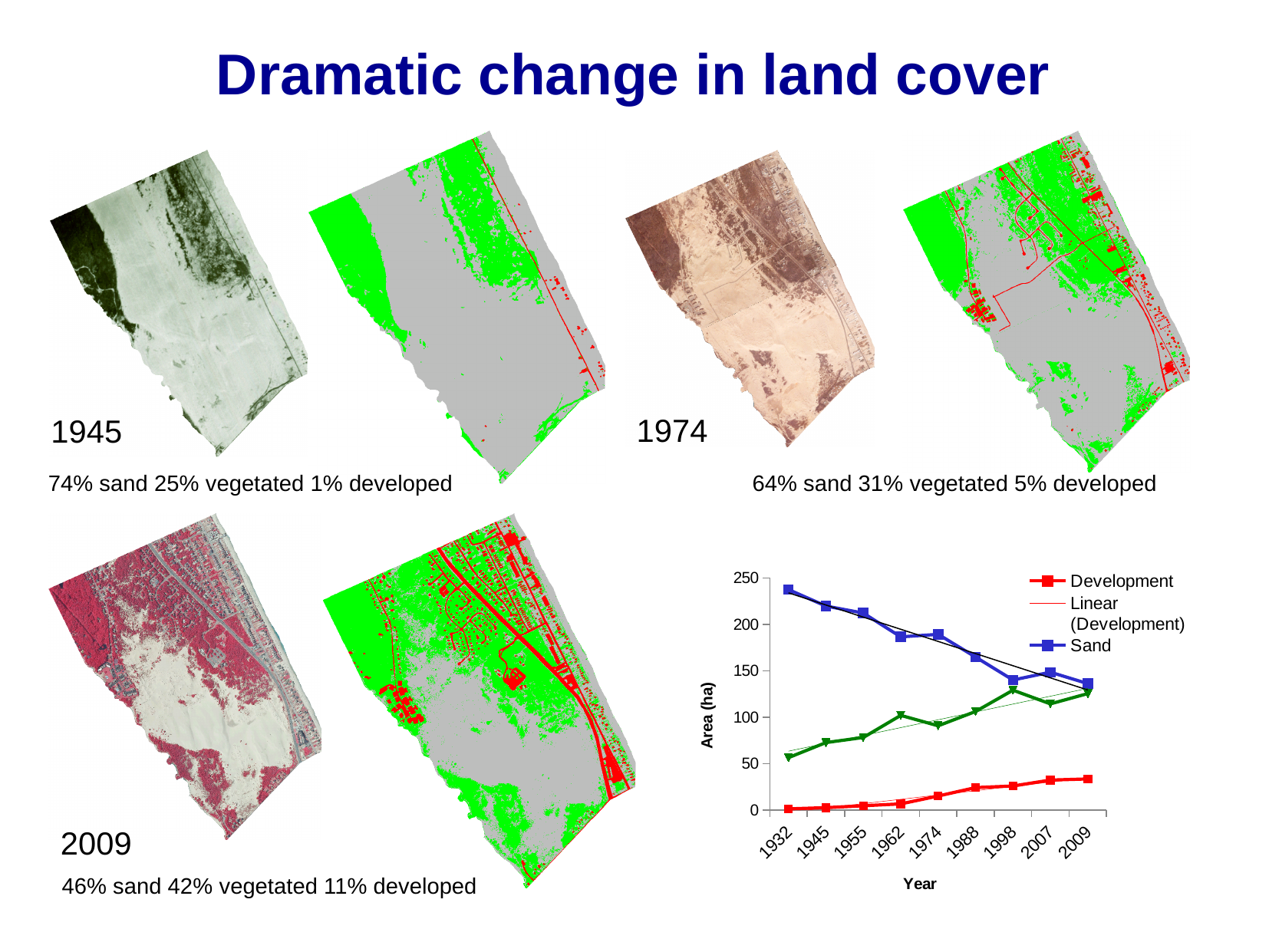
In which year is the Sand series at its highest? 1932 Is the value for Sand in 1932 greater or less than 200? greater Is the value for Development in 2009 greater or less than 50? less Is the value for Sand in 2009 greater or less than 150? less What is the label on the chart's y axis? Area (ha) How many series does the chart's legend list? 3 Which is larger in 1932, Sand or Development? Sand Does the Sand series rise or fall from 1932 to 2009? fall Does the Development series rise or fall from 1932 to 2009? rise How many years are plotted along the x axis of the chart? 9 What kind of chart is shown on the slide? line chart